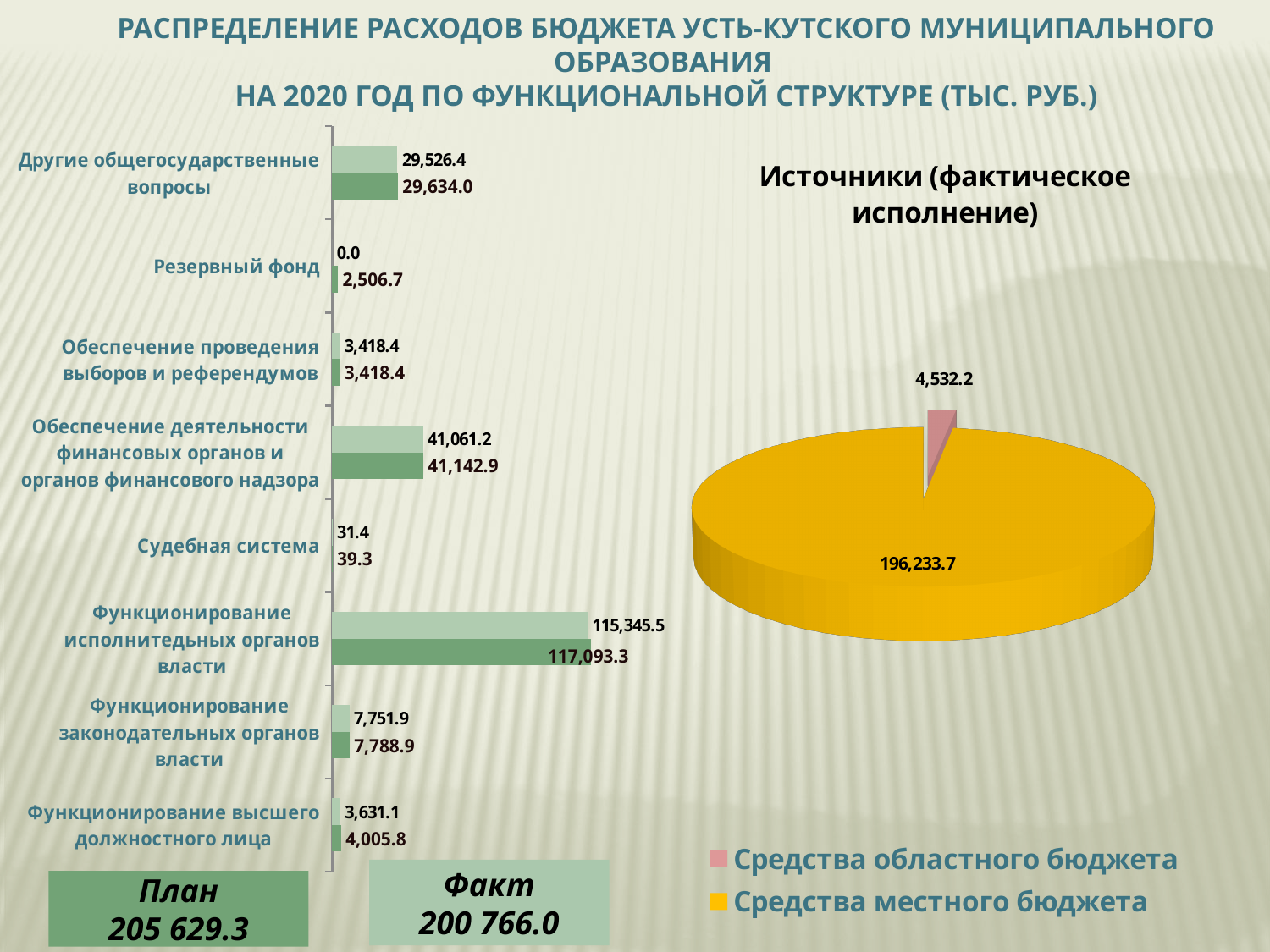
In the bar chart on the left, what is the dark green (План) value for «Резервный фонд»? 2,506.7 How many entries does the legend of the pie chart «Источники (фактическое исполнение)» list? 2 In the bar chart on the left, how many expenditure categories are shown? 8 In the bar chart on the left, which is larger: the light green (Факт) value for «Обеспечение деятельности финансовых органов и органов финансового надзора» or for «Другие общегосударственные вопросы»? Обеспечение деятельности финансовых органов и органов финансового надзора What kind of chart is the chart on the left side of the slide? bar chart In the bar chart on the left, what is the light green (Факт) value for «Резервный фонд»? 0.0 What kind of chart is the chart titled «Источники (фактическое исполнение)»? pie chart In the bar chart on the left, which category has the highest values? Функционирование исполнительных органов власти In the bar chart on the left, what is the difference between the dark green (План) and light green (Факт) values for «Функционирование исполнительных органов власти»? 1,747.8 In the bar chart on the left, what is the dark green (План) value for «Судебная система»? 39.3 In the pie chart «Источники (фактическое исполнение)», what is the value for «Средства областного бюджета»? 4,532.2 In the pie chart «Источники (фактическое исполнение)», what is the total of the two slices? 200,765.9